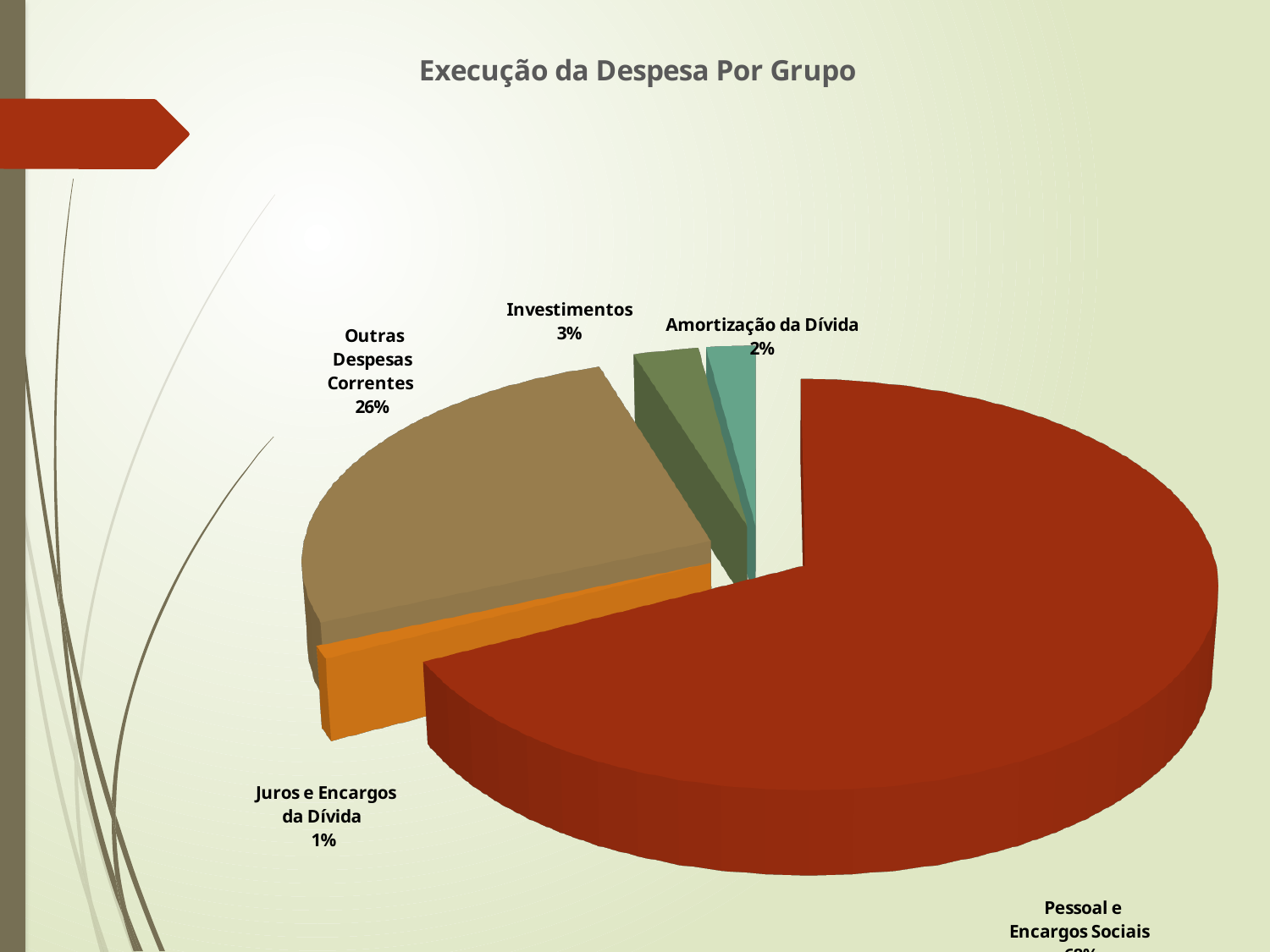
What percentage is shown for Investimentos? 3% How many slices does the pie chart have? 5 Which group has the smallest slice of the pie? Juros e Encargos da Dívida Which group has the largest slice of the pie? Pessoal e Encargos Sociais What is the difference in percentage points between Amortização da Dívida and Juros e Encargos da Dívida? 1% What is the title of the chart? Execução da Despesa Por Grupo Which is larger, the share for Investimentos or the share for Amortização da Dívida? Investimentos What percentage is shown for Juros e Encargos da Dívida? 1% What kind of chart is shown on the slide? Pie chart What share of the pie does Outras Despesas Correntes represent? 26% What percentage is shown for Amortização da Dívida? 2% What is the difference in percentage points between Outras Despesas Correntes and Investimentos? 23%